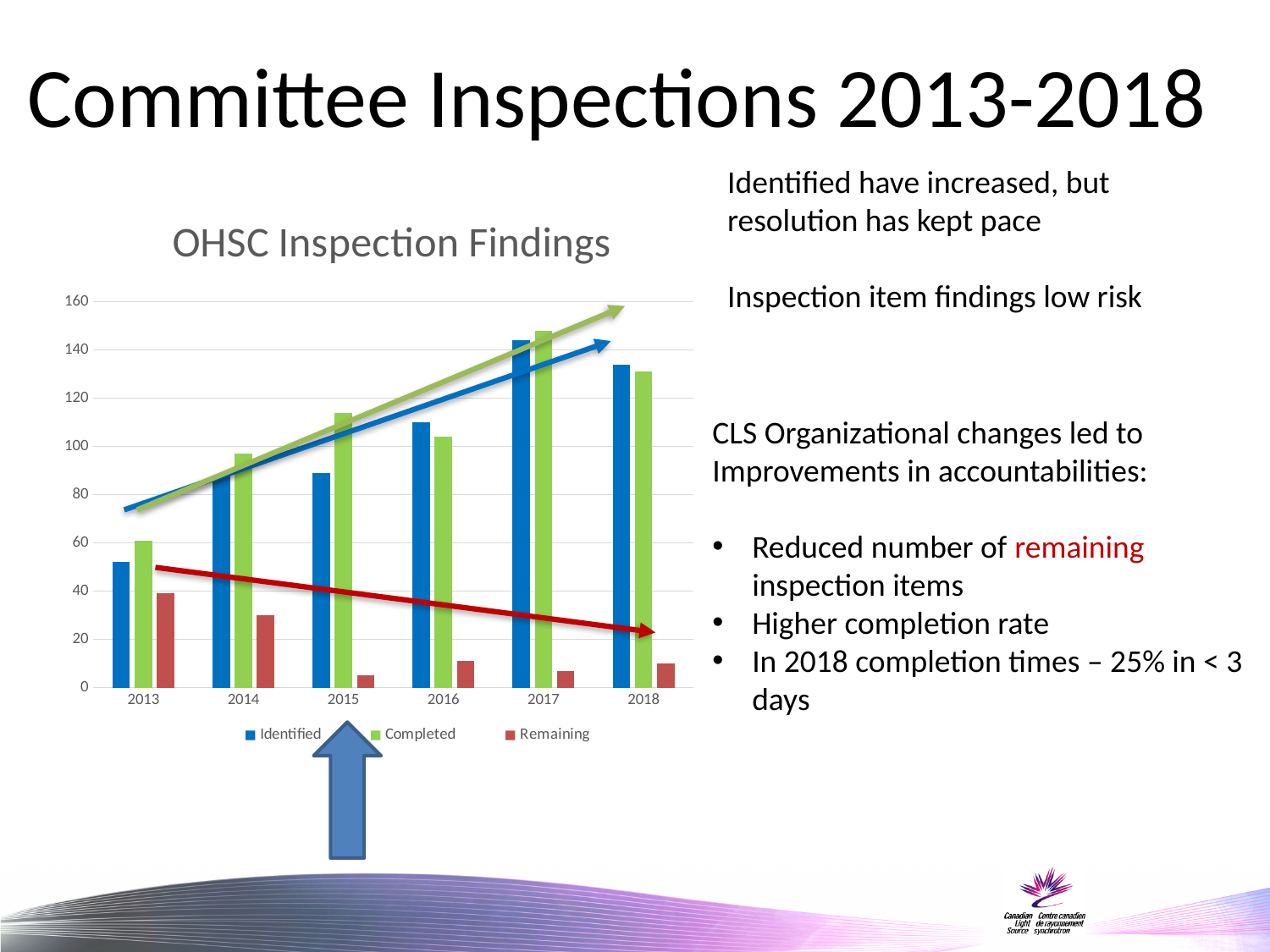
In which year is the Remaining value highest? 2013 Does the Remaining series generally rise or fall from 2013 to 2018? fall In which year is the Identified value lowest? 2013 In 2015, which is larger: Identified or Completed? Completed In which year is the Identified value highest? 2017 What is the title of the chart? OHSC Inspection Findings How many years are shown along the x axis of the chart? 6 Is the Identified value for 2016 greater or less than 100? greater What type of chart is shown on the slide? bar chart How many series does the chart legend list? 3 Is the Completed value for 2018 greater or less than 120? greater Which series is shown in red in the chart? Remaining